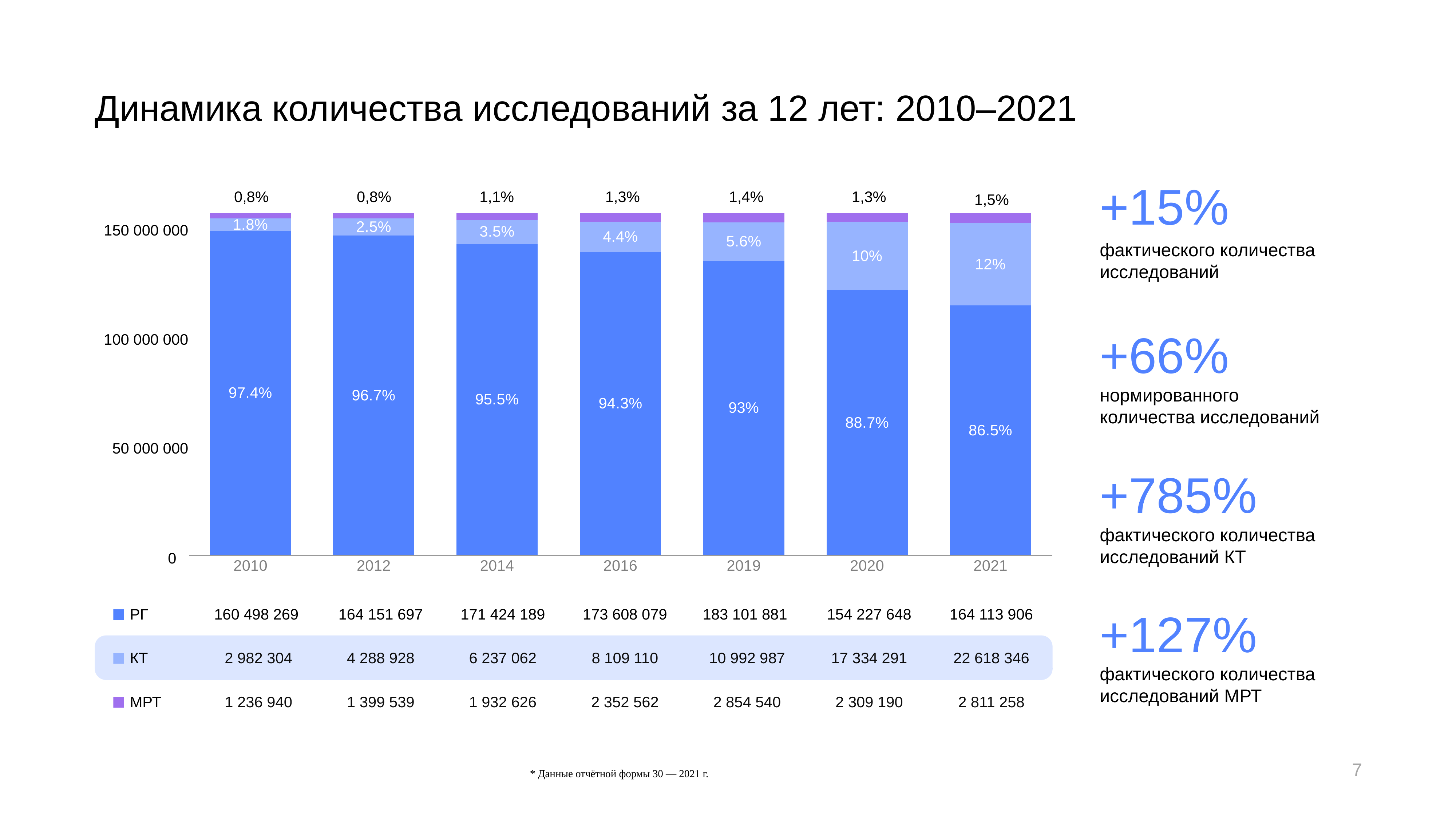
What is the difference between the КТ values for 2021 and 2020? 5 284 055 What share is labelled for МРТ in 2019? 1,4% In which year is the РГ value lowest? 2020 According to the table, what is the КТ value for 2016? 8 109 110 What share is labelled for КТ in 2021? 12% What kind of chart is shown on the slide? Stacked bar chart In which year is the КТ value highest? 2021 How many series does the legend list? 3 Which is larger, the МРТ value for 2019 or for 2020? 2019 Does the КТ share of the bars rise or fall from 2010 to 2021? Rises What share of the 2010 bar is labelled for РГ? 97.4% How many years are shown on the x axis? 7